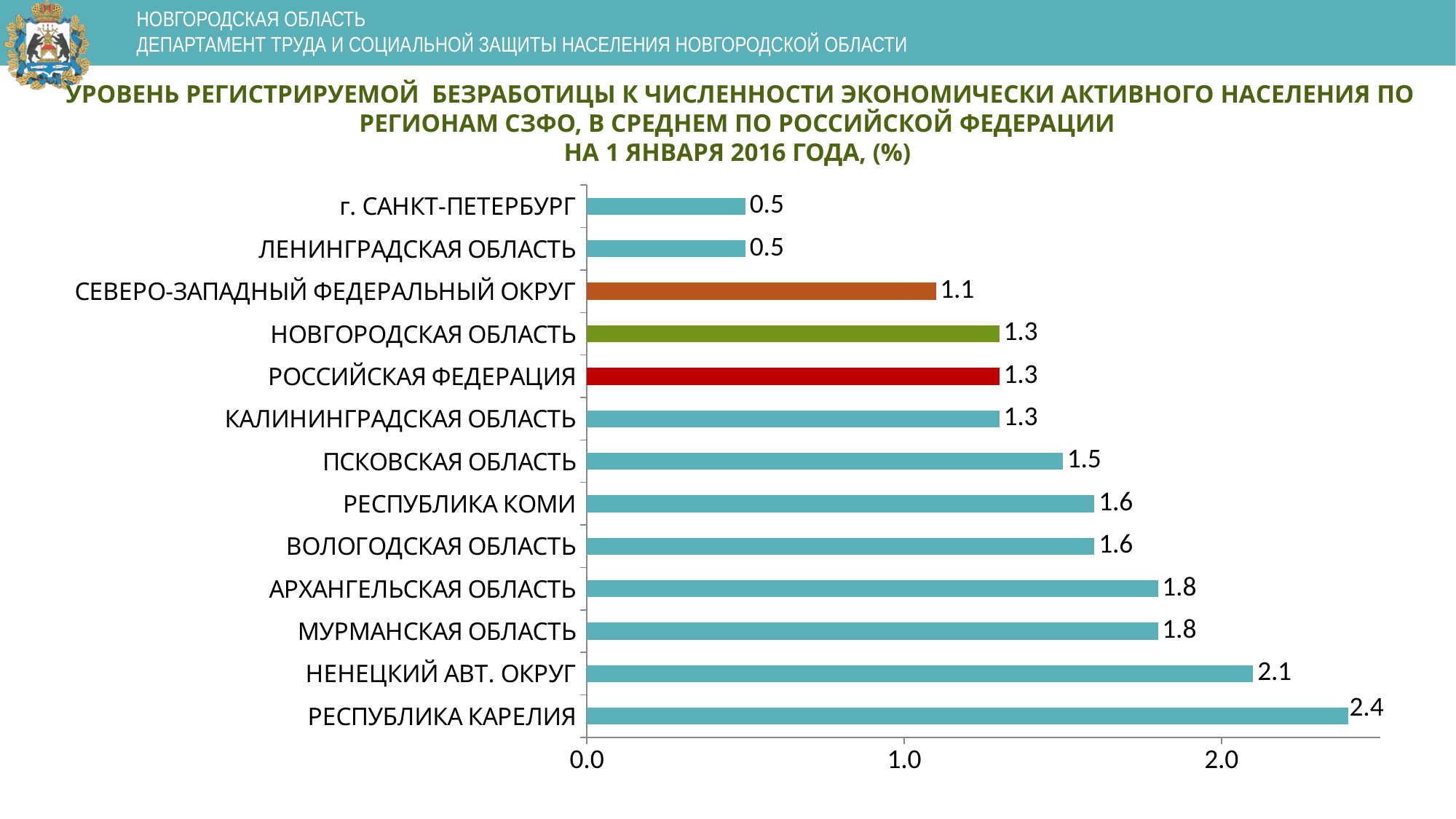
What is the lowest value shown on the chart? 0.5 Is the value for АРХАНГЕЛЬСКАЯ ОБЛАСТЬ greater or less than 1.0? greater What is the value for СЕВЕРО-ЗАПАДНЫЙ ФЕДЕРАЛЬНЫЙ ОКРУГ? 1.1 What is the value for НОВГОРОДСКАЯ ОБЛАСТЬ? 1.3 Which category has the highest value? РЕСПУБЛИКА КАРЕЛИЯ What is the difference between the values for РЕСПУБЛИКА КАРЕЛИЯ and НОВГОРОДСКАЯ ОБЛАСТЬ? 1.1 What kind of chart is shown on the slide? bar chart What is the value for РЕСПУБЛИКА КОМИ? 1.6 What is the value for НЕНЕЦКИЙ АВТ. ОКРУГ? 2.1 Which is larger, the value for НЕНЕЦКИЙ АВТ. ОКРУГ or the value for ПСКОВСКАЯ ОБЛАСТЬ? НЕНЕЦКИЙ АВТ. ОКРУГ What colour is the bar for НОВГОРОДСКАЯ ОБЛАСТЬ? green How many categories are shown on the chart? 13